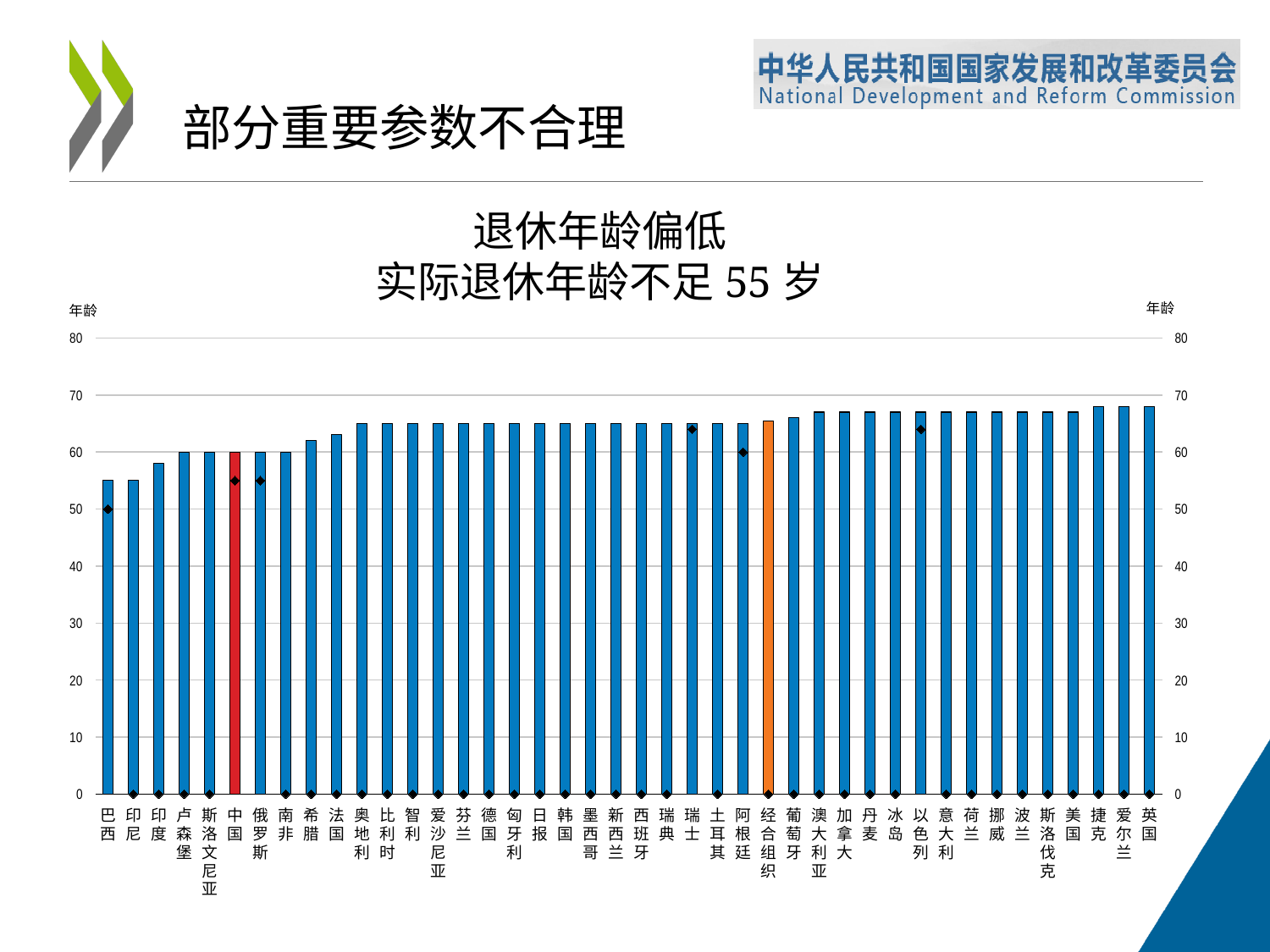
Which bar is taller, 印度 or 德国? 德国 Which category is shown with a red bar? 中国 What is the value of the bar for 中国? 60 Which category is shown with an orange bar? 经合组织 What kind of chart is shown on the slide? bar chart Is the value of the bar for 法国 greater or less than 60? greater What is the value of the bar for 卢森堡? 60 Is the value of the bar for 英国 greater or less than 60? greater What value does the diamond marker for 巴西 sit at? 50 Which bar is taller, 英国 or 巴西? 英国 Is the value of the bar for 巴西 greater or less than 60? less Do the bar values generally rise or fall from left to right along the x axis? rise